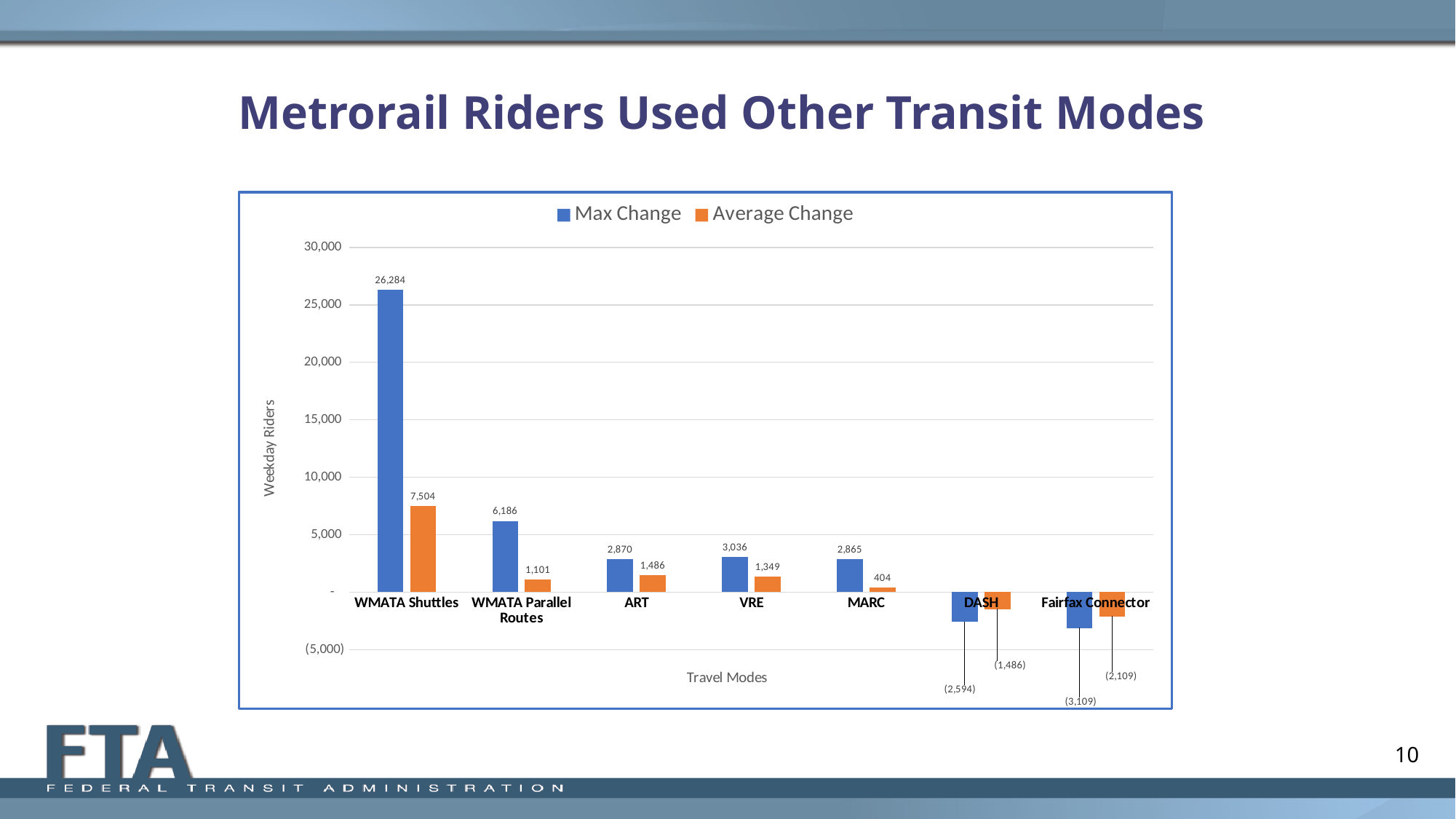
Which travel mode has the highest Max Change? WMATA Shuttles What is the Average Change value for MARC? 404 What is the difference between the Max Change and Average Change for WMATA Shuttles? 18,780 What is the Max Change value for Fairfax Connector? (3,109) Which is larger, the Max Change for VRE or the Max Change for ART? VRE What kind of chart is shown on the slide? Bar chart What is the Average Change value for DASH? (1,486) How many travel modes are shown on the x axis? 7 What is the label of the y axis? Weekday Riders What is the Max Change value for WMATA Shuttles? 26,284 Which travel mode has the lowest Average Change? Fairfax Connector How many series does the legend list? 2